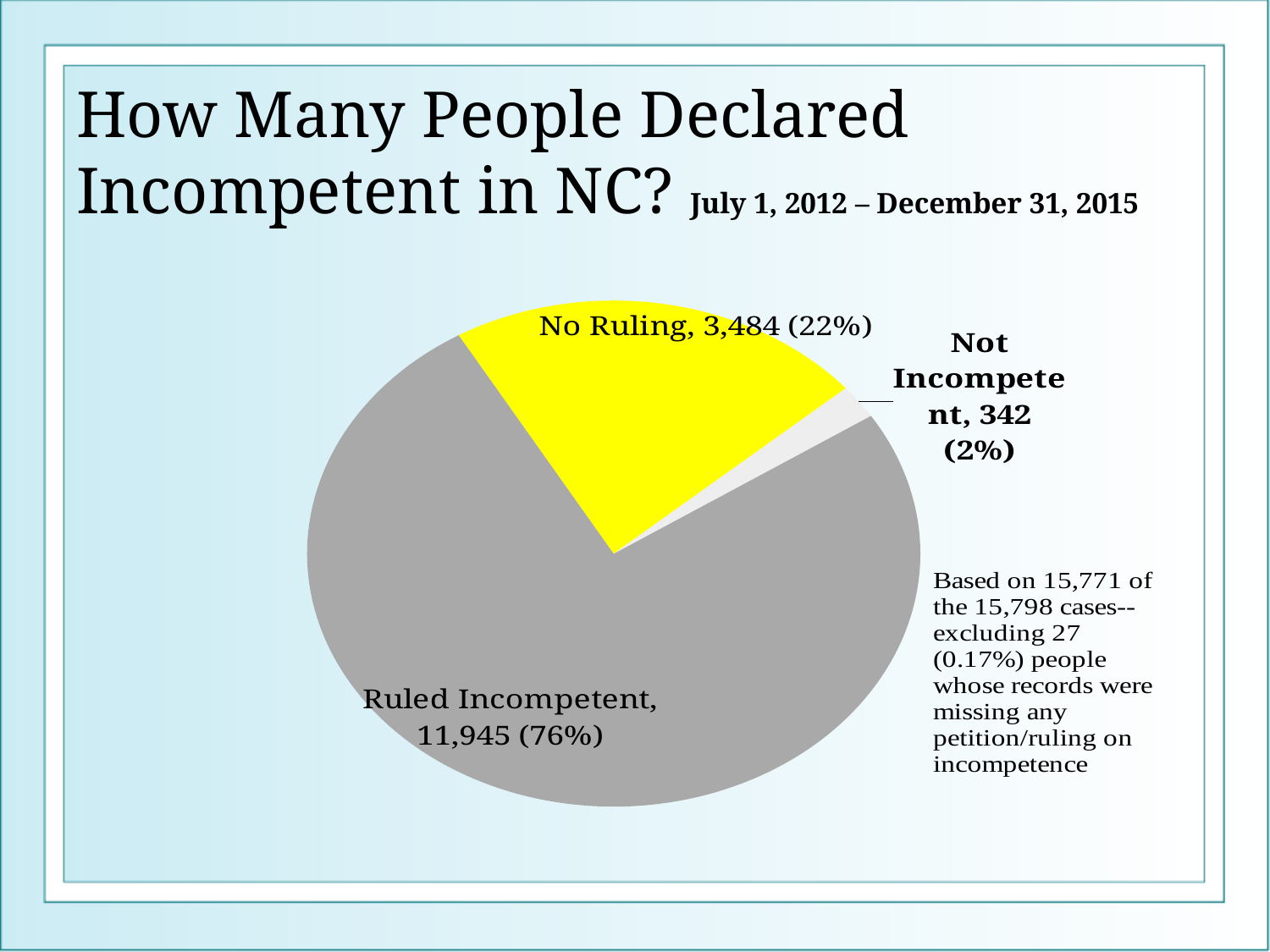
Which slice is larger, No Ruling or Not Incompetent? No Ruling How many people were ruled Not Incompetent according to the pie chart? 342 How many people were Ruled Incompetent according to the pie chart? 11,945 How many cases had No Ruling according to the pie chart? 3,484 What share of the pie does the Not Incompetent slice represent? 2% What kind of chart is shown on the slide? pie chart What share of the pie does the Ruled Incompetent slice represent? 76% Which category has the smallest slice of the pie chart? Not Incompetent How many slices does the pie chart have? 3 What share of the pie does the No Ruling slice represent? 22% What is the difference between the number of Ruled Incompetent cases and No Ruling cases? 8,461 Which category has the largest slice of the pie chart? Ruled Incompetent